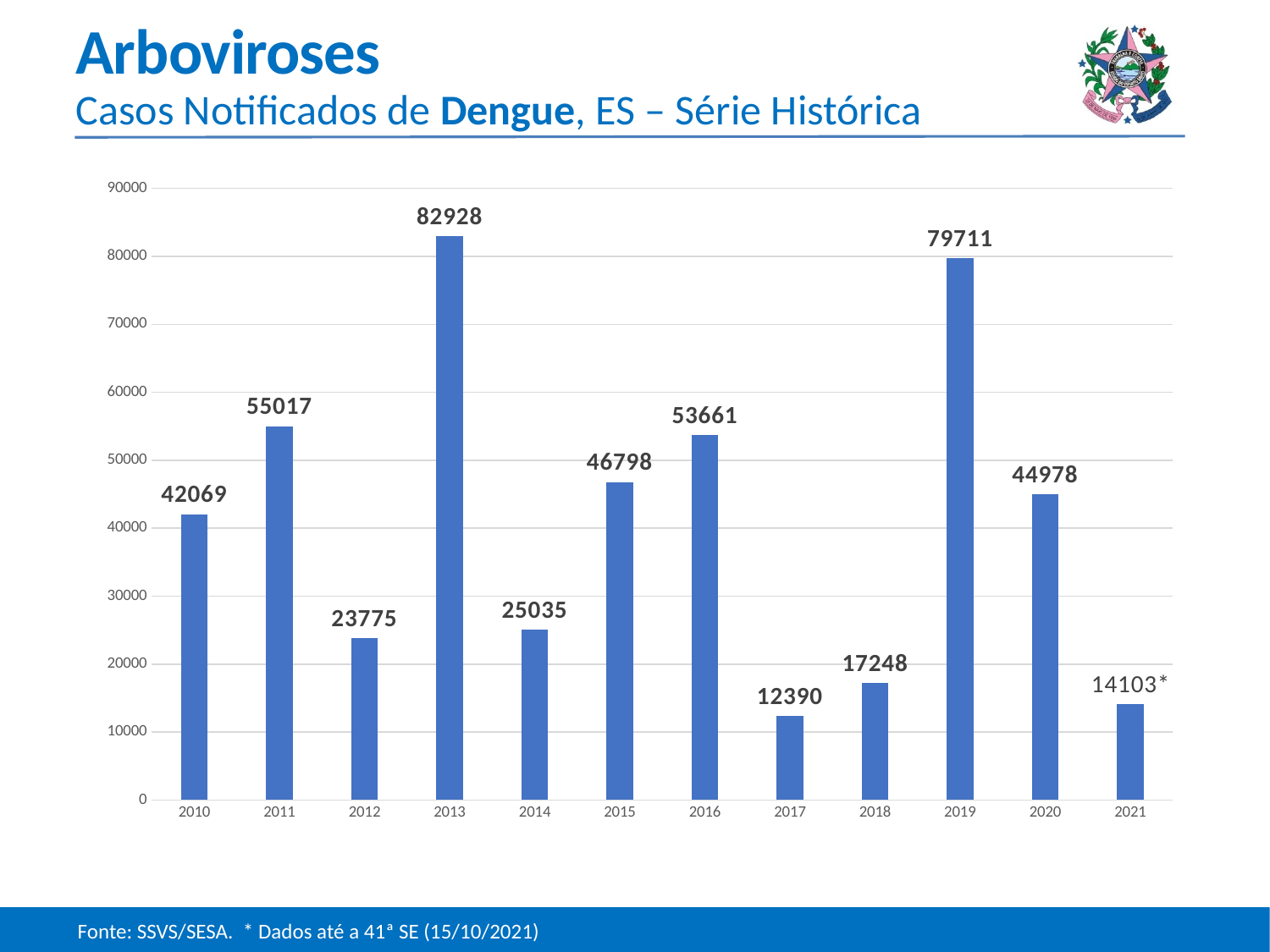
Is the value for 2020 greater or less than 40000? greater What is the value shown for 2017? 12390 What is the difference between the values for 2011 and 2010? 12948 Do the values rise or fall from 2016 to 2017? fall Which year has more notified cases, 2015 or 2016? 2016 What kind of chart is shown on the slide? bar chart What value is labelled on the bar for 2021? 14103* Which year has the lowest number of notified dengue cases? 2017 Which year has the highest number of notified dengue cases? 2013 What is the difference between the values for 2013 and 2019? 3217 How many years are shown on the x axis? 12 How many notified dengue cases are shown for 2013? 82928